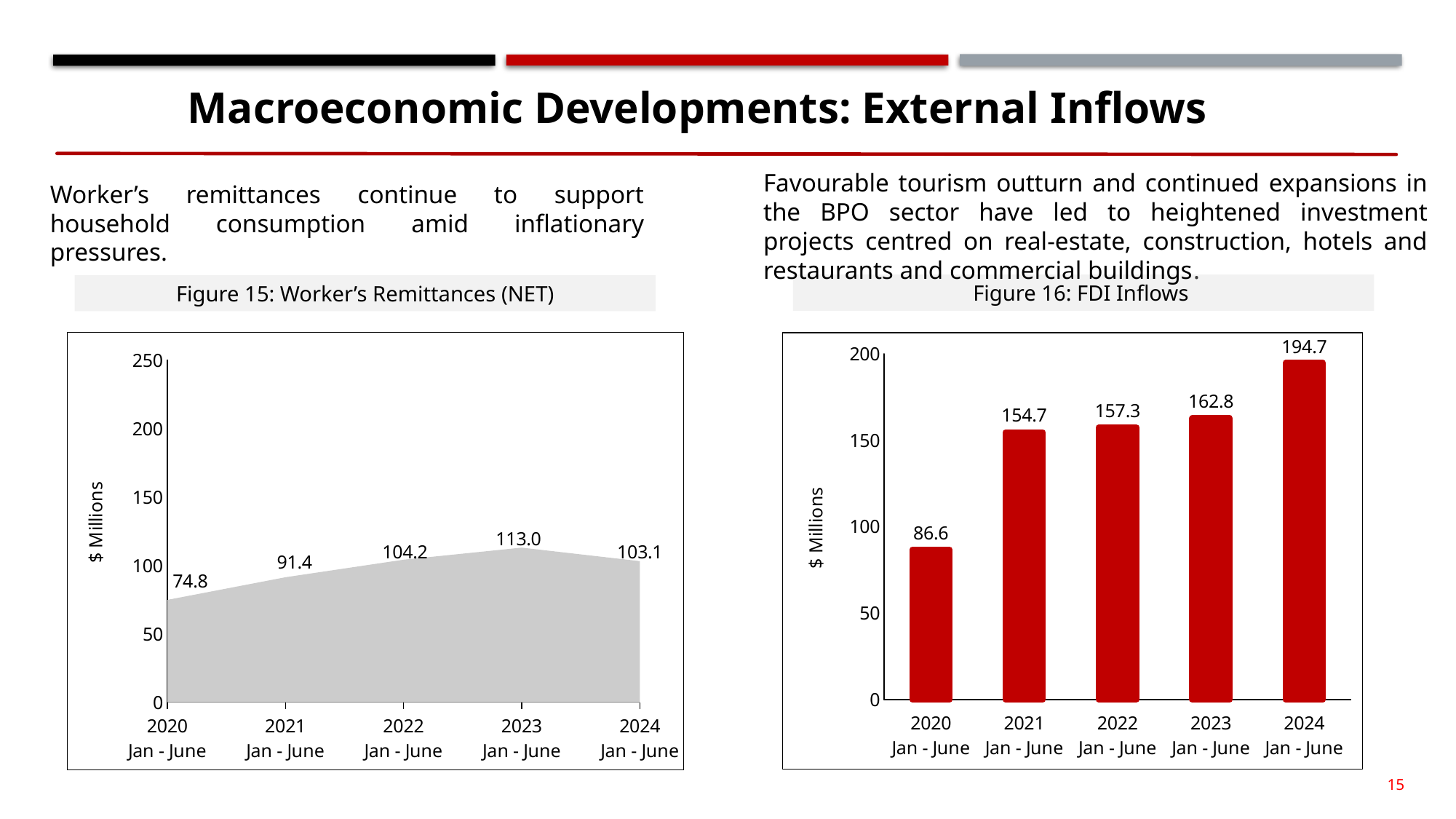
In Figure 15: Worker's Remittances (NET), which year has the lowest value? 2020 In Figure 15: Worker's Remittances (NET), how many data points are plotted? 5 In Figure 16: FDI Inflows, what is the difference between the 2024 and 2020 values? 108.1 In Figure 16: FDI Inflows, which year has the highest value? 2024 In Figure 15: Worker's Remittances (NET), which year has the highest value? 2023 In Figure 16: FDI Inflows, what kind of chart is shown? Bar chart In Figure 16: FDI Inflows, which is larger, the value for 2021 or the value for 2023? 2023 In Figure 15: Worker's Remittances (NET), what is the value for 2020 Jan - June? 74.8 In Figure 15: Worker's Remittances (NET), what kind of chart is shown? Area chart In Figure 16: FDI Inflows, what is the value for 2022 Jan - June? 157.3 In Figure 15: Worker's Remittances (NET), what is the difference between the 2023 and 2024 values? 9.9 In Figure 16: FDI Inflows, do the values rise or fall from 2020 to 2024? Rise